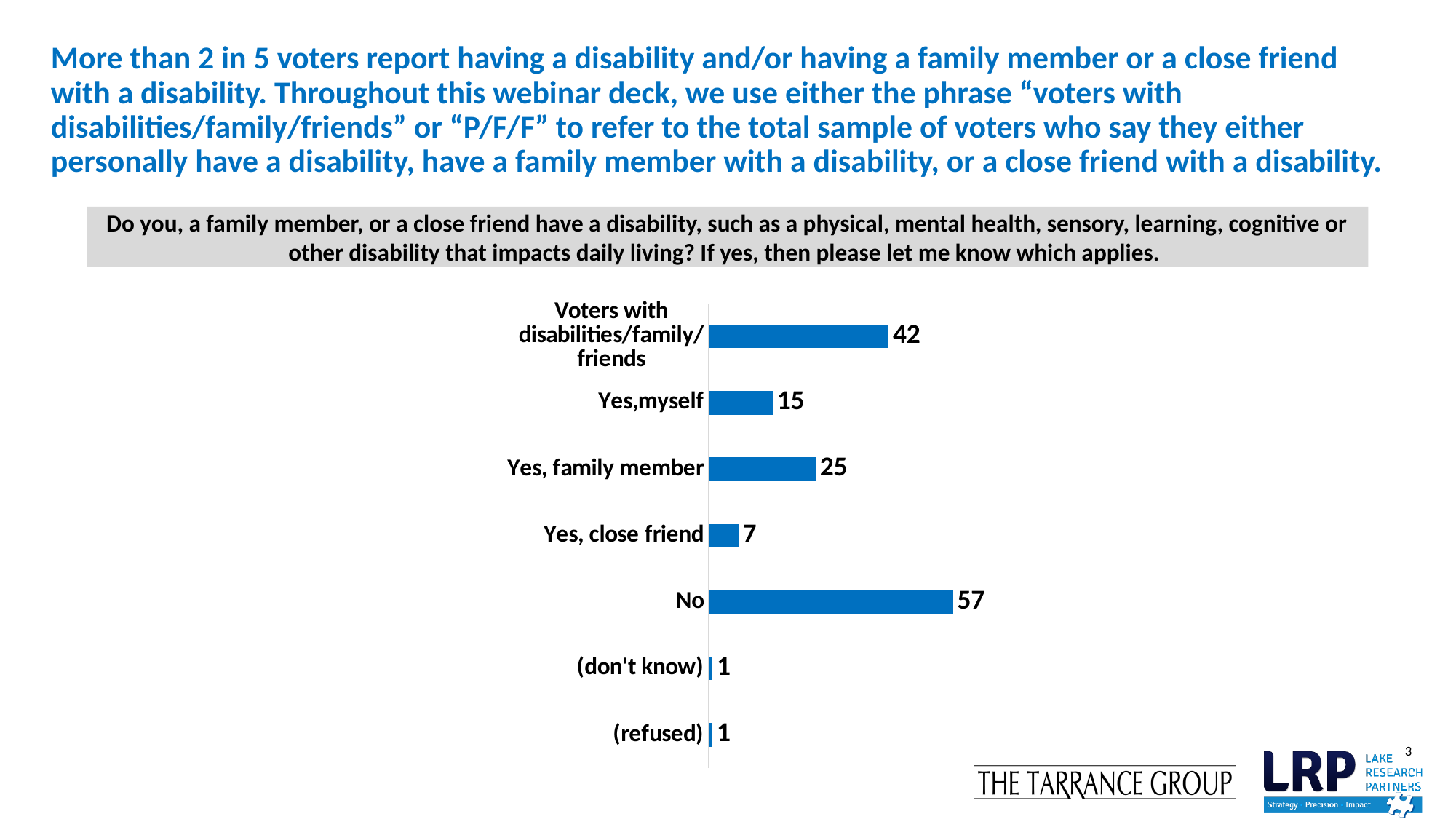
What value is shown for "Yes, close friend"? 7 Which is larger, the value for "Yes,myself" or the value for "Yes, close friend"? Yes,myself What value is shown for "Voters with disabilities/family/friends"? 42 What colour are the bars in the chart? Blue What is the difference between the values for "No" and "Voters with disabilities/family/friends"? 15 What is the difference between the values for "Yes, family member" and "Yes,myself"? 10 What value is shown for "(don't know)"? 1 How many categories are plotted in the chart? 7 What value is shown for "Yes, family member"? 25 Which category has the highest value? No What kind of chart is shown on the slide? Bar chart What value is shown for "No"? 57